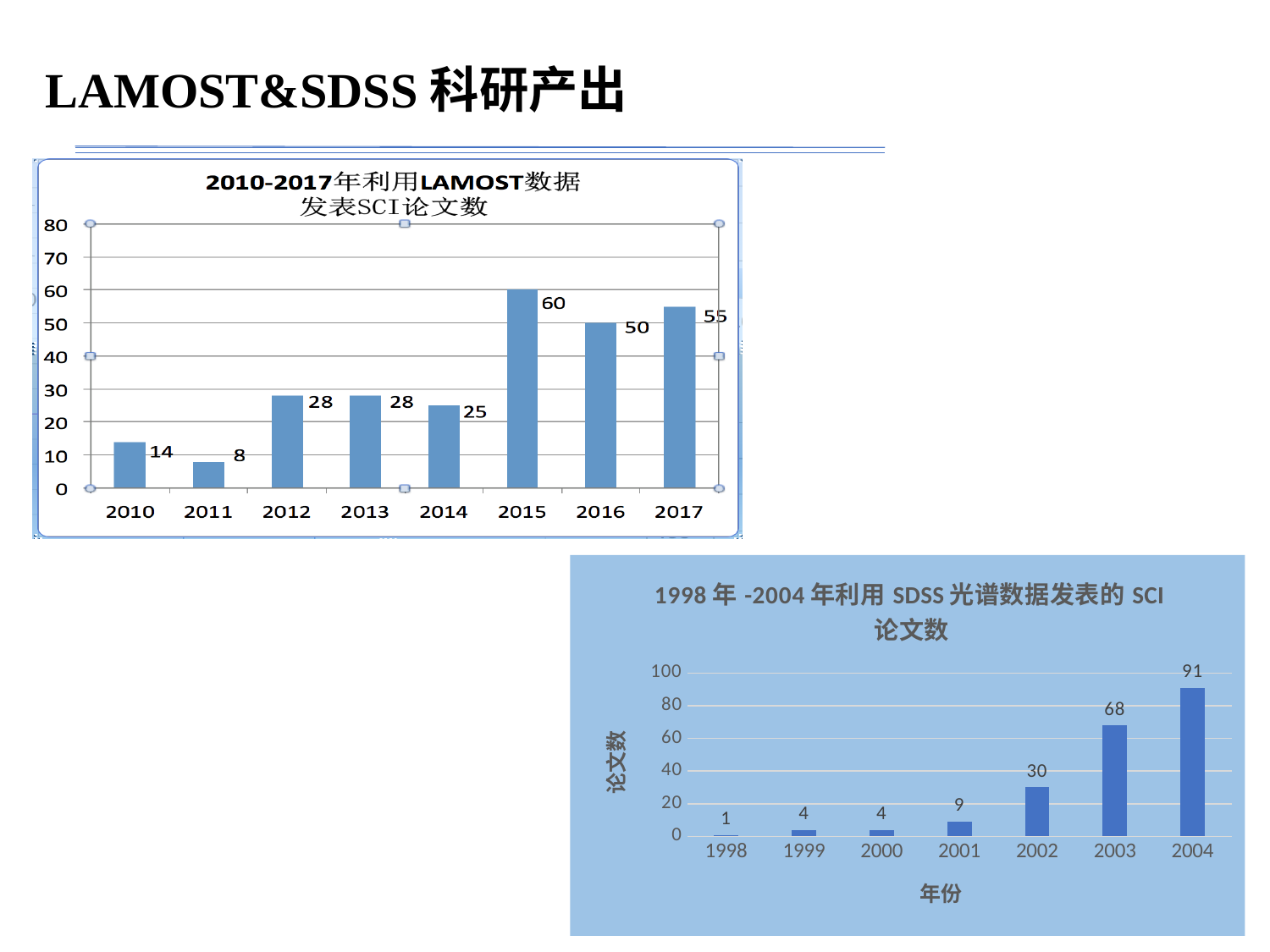
What kind of chart is the SDSS chart (bottom right)? bar chart In the SDSS chart (bottom right), which year has the highest number of papers? 2004 In the LAMOST chart (top left), how many SCI papers were published in 2015? 60 In the SDSS chart (bottom right), which is larger, the value for 2002 or the value for 2001? 2002 In the LAMOST chart (top left), what is the difference between the 2016 and 2014 values? 25 In the SDSS chart (bottom right), what is the difference between the 2004 and 2003 values? 23 In the LAMOST chart (top left), which year has the highest number of papers? 2015 In the LAMOST chart (top left), is the value for 2017 greater or less than 50? greater In the LAMOST chart (top left), which year has the lowest number of papers? 2011 In the LAMOST chart (top left), how many years are shown on the x axis? 8 In the SDSS chart (bottom right), how many SCI papers were published in 2003? 68 In the SDSS chart (bottom right), do the values generally rise or fall from 1998 to 2004? rise